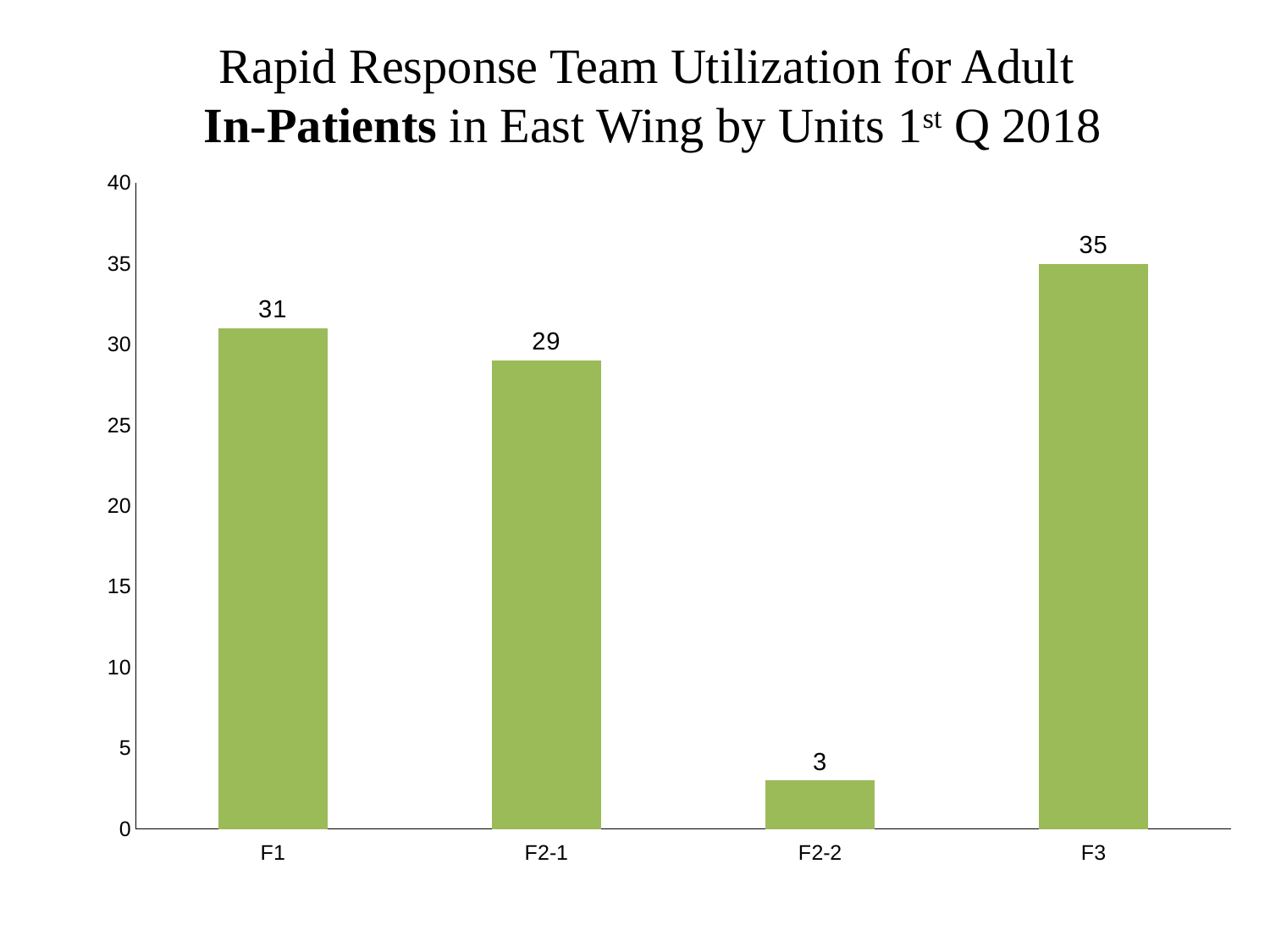
What is the difference between the values for F2-1 and F2-2? 26 Is the value for F2-2 greater or less than 5? less How many units are shown on the x axis? 4 What kind of chart is shown on the slide? bar chart What is the value for F2-2? 3 What is the value for F1? 31 Which unit has the highest value? F3 What is the value for F3? 35 Which unit has the lowest value? F2-2 Which is larger, the value for F1 or the value for F2-1? F1 What is the value for F2-1? 29 What is the difference between the values for F3 and F1? 4